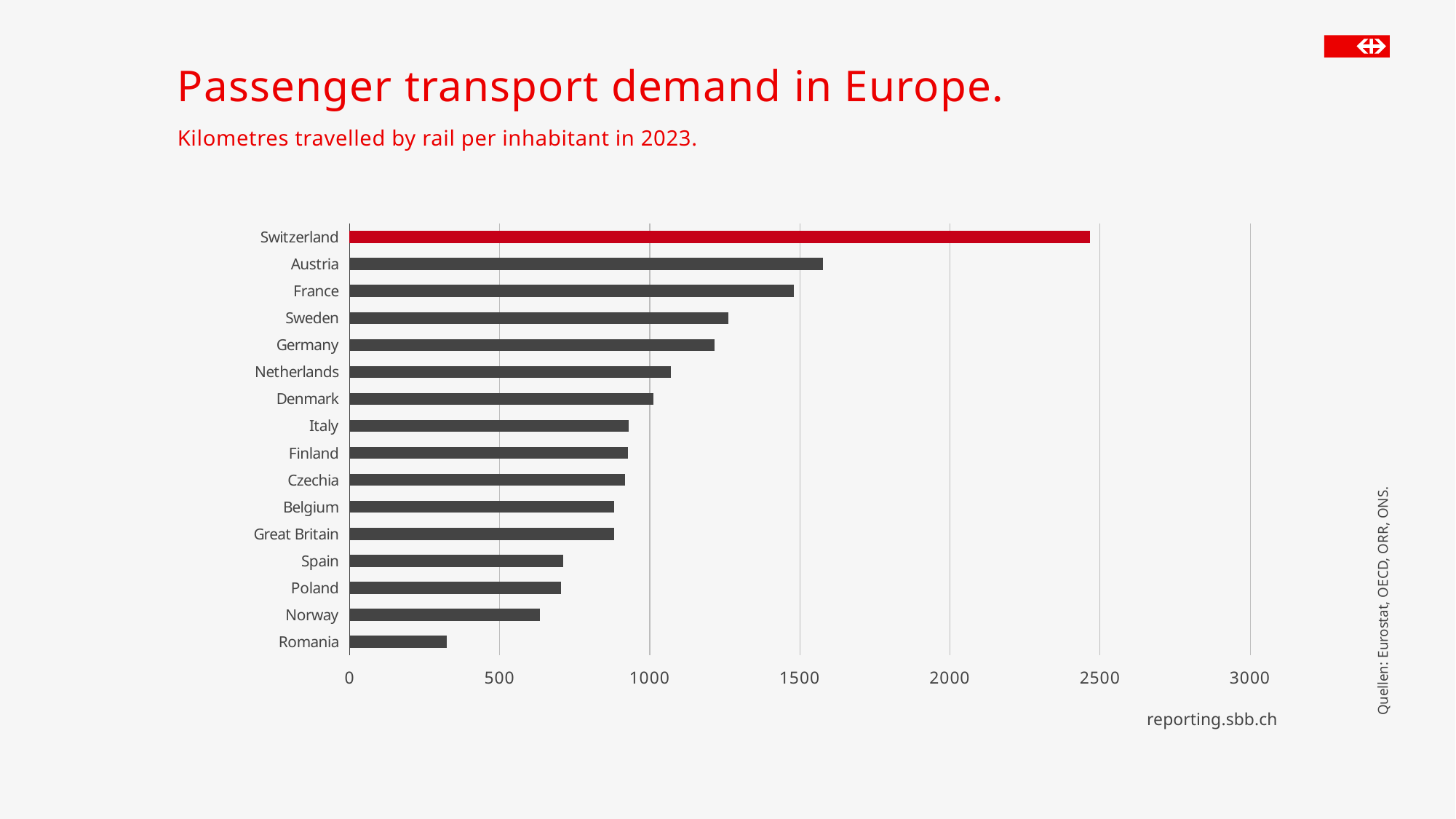
Which has a larger value, Germany or Netherlands? Germany Is the value for Switzerland greater or less than 2000? greater Is the value for Romania greater or less than 500? less Which country has the lowest value in the chart? Romania Which country has the highest value in the chart? Switzerland Is the value for Austria greater or less than 1500? greater How many countries are shown in the chart? 16 Which has a larger value, Norway or Romania? Norway What kind of chart is shown on the slide? Bar chart